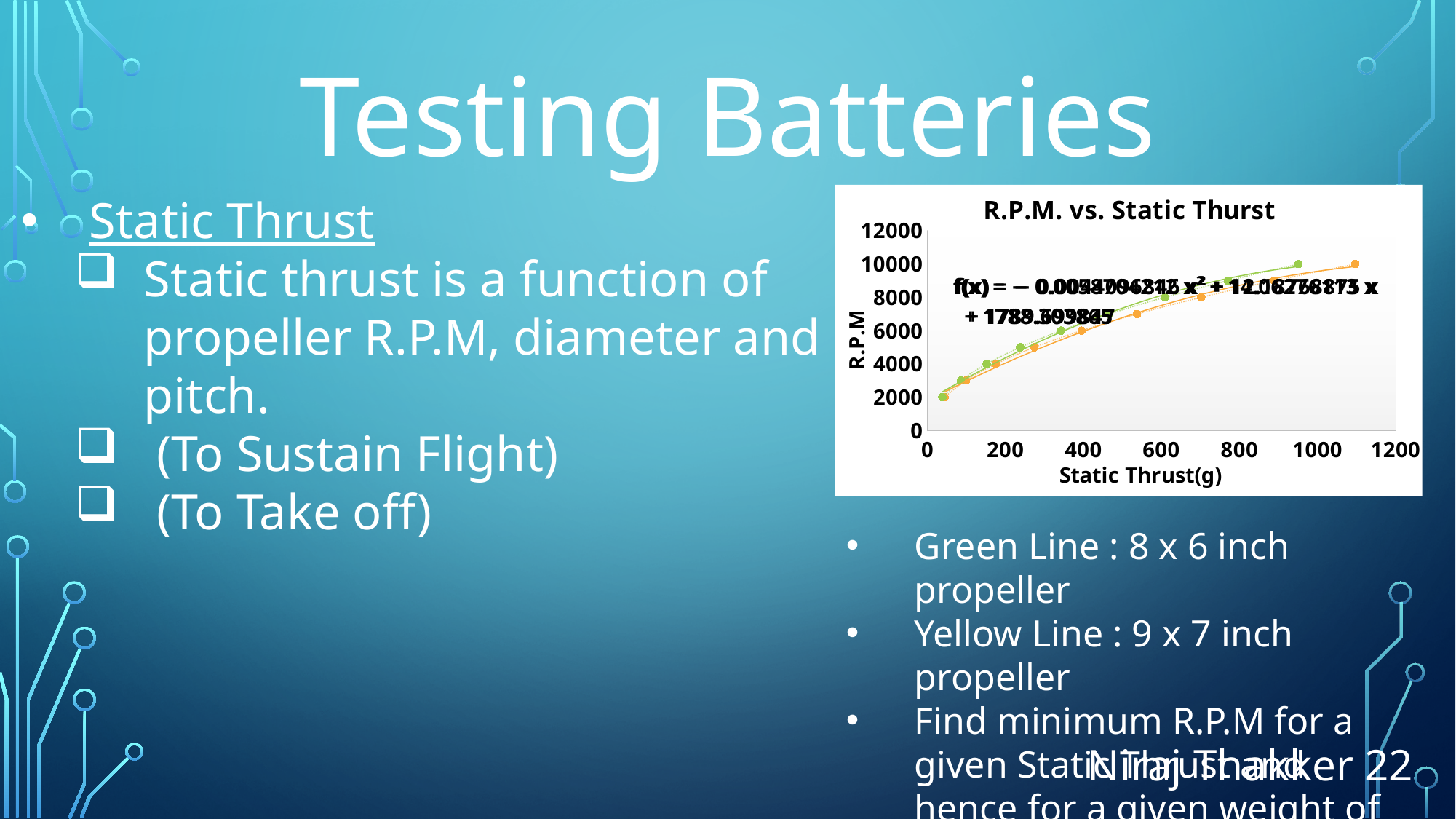
Do the R.P.M. values rise or fall as static thrust increases? Rise What kind of chart is shown on the slide? Scatter chart Which series reaches the larger static thrust value, the green series or the orange series? Orange series What is the highest value shown on the y axis of the chart? 12000 Is the highest R.P.M. value plotted in the chart greater or less than 8000? greater Is the static thrust of the rightmost green point greater or less than 1000? less How many data series are plotted in the chart? 2 What is the highest value shown on the x axis of the chart? 1200 Is the lowest R.P.M. value plotted in the chart greater or less than 4000? less What is the title of the chart? R.P.M. vs. Static Thurst What is the label of the x axis of the chart? Static Thrust(g)